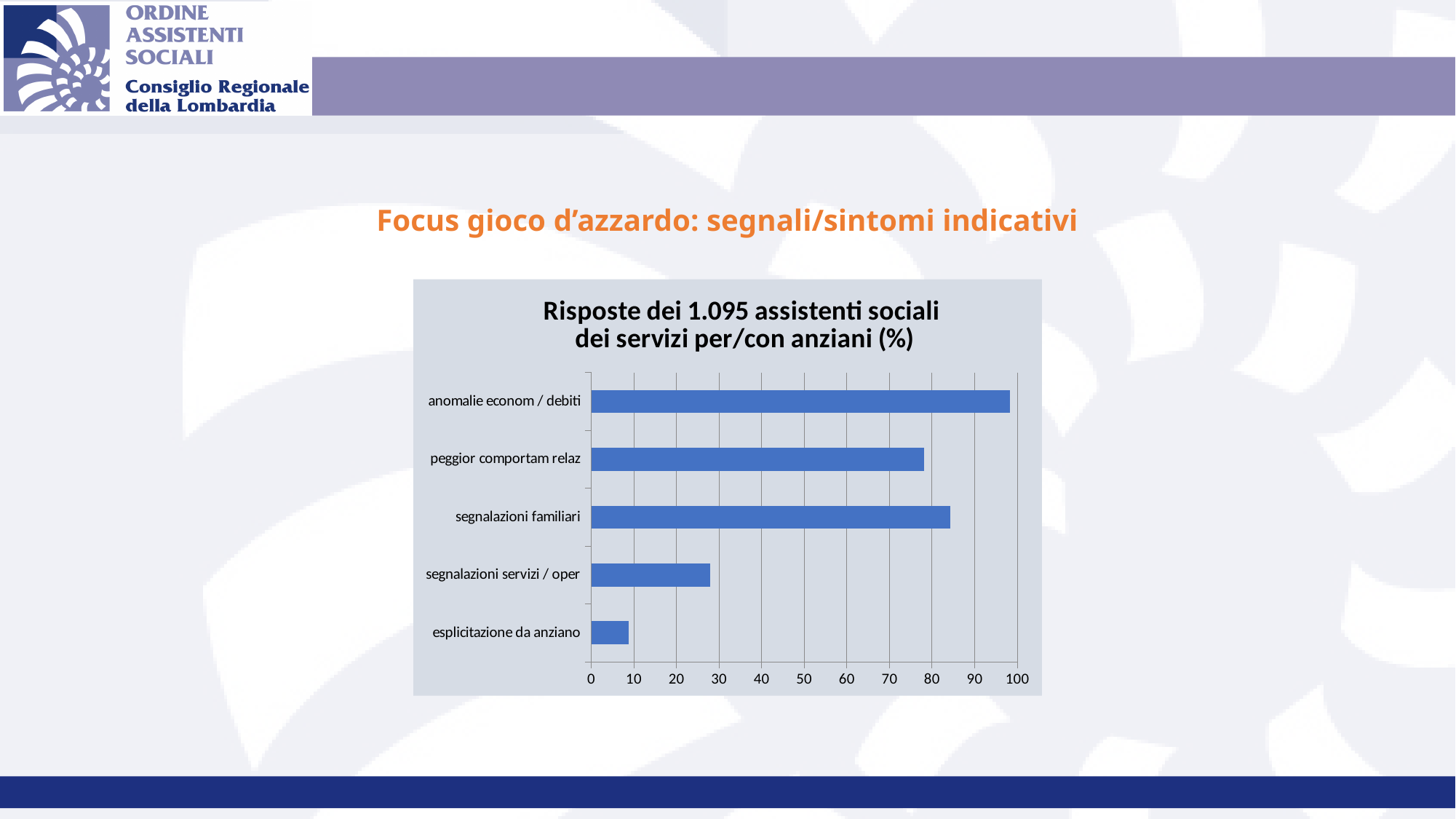
Which is larger, the value for segnalazioni familiari or the value for peggior comportam relaz? segnalazioni familiari Which is larger, the value for segnalazioni servizi / oper or the value for esplicitazione da anziano? segnalazioni servizi / oper Is the value for segnalazioni servizi / oper greater or less than 30? less What kind of chart is shown on the slide? bar chart How many categories are shown in the chart? 5 What is the maximum value shown on the horizontal axis? 100 Which category has the lowest value? esplicitazione da anziano Which category has the highest value? anomalie econom / debiti Is the value for anomalie econom / debiti greater or less than 90? greater Is the value for esplicitazione da anziano greater or less than 10? less What is the title of the chart? Risposte dei 1.095 assistenti sociali dei servizi per/con anziani (%)